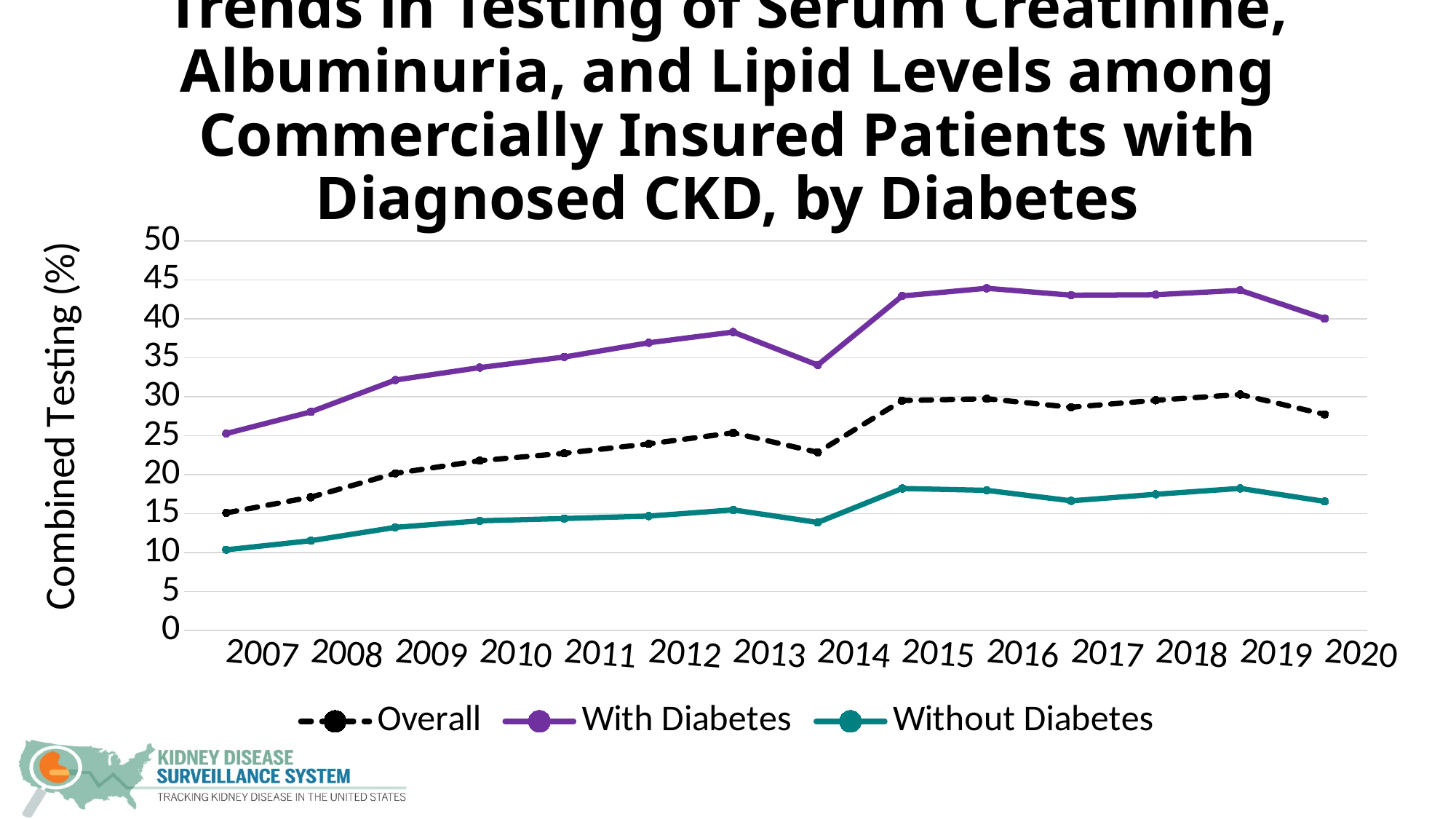
What kind of chart is shown on the slide? Line chart For the With Diabetes series, which year has the larger value, 2013 or 2014? 2013 Which series has the highest values across the chart? With Diabetes Is the value for With Diabetes in 2016 greater or less than 40? greater In which year is the Overall series at its lowest? 2007 How many series does the legend list? 3 Does the Overall series rise or fall from 2007 to 2012? Rises Is the value for Without Diabetes in 2007 greater or less than 15? less How many years are plotted along the x axis? 14 Is the value for With Diabetes in 2007 greater or less than 30? less Which series has the lowest values across the chart? Without Diabetes